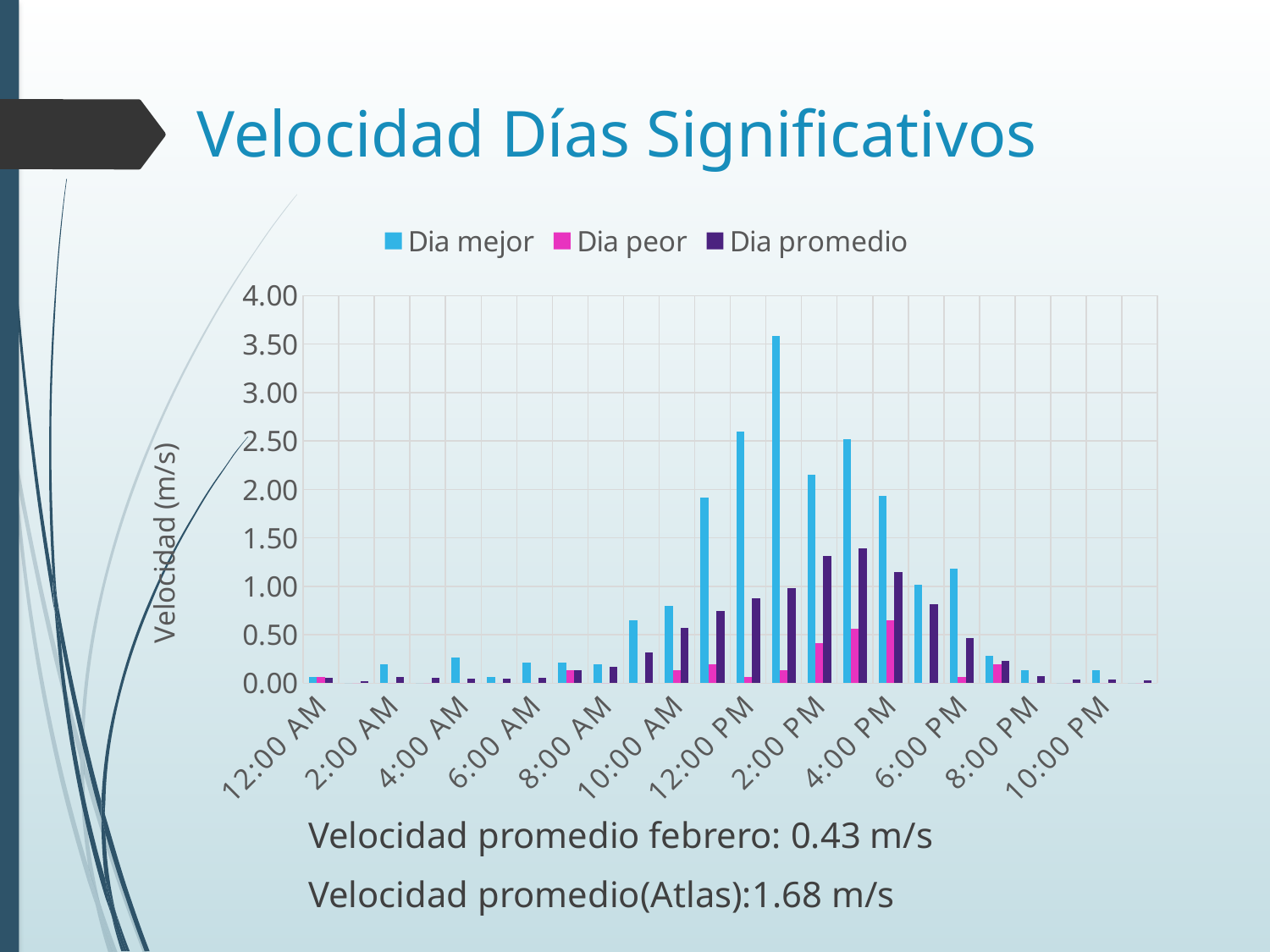
What are the series names listed in the legend? Dia mejor, Dia peor, Dia promedio How many series does the legend list? 3 Which series contains the tallest bar on the chart? Dia mejor Is the Dia promedio value at 4:00 PM greater or less than 1.00? greater At 2:00 PM, which is larger: Dia mejor or Dia promedio? Dia mejor What kind of chart is shown on the slide? bar chart Is the tallest Dia mejor bar greater or less than 3.00? greater Do the Dia mejor values rise or fall from 2:00 PM to 8:00 PM? fall Is the Dia mejor value at 10:00 AM greater or less than 0.50? greater What is the title of the vertical axis? Velocidad (m/s) What is the highest tick value shown on the vertical axis? 4.00